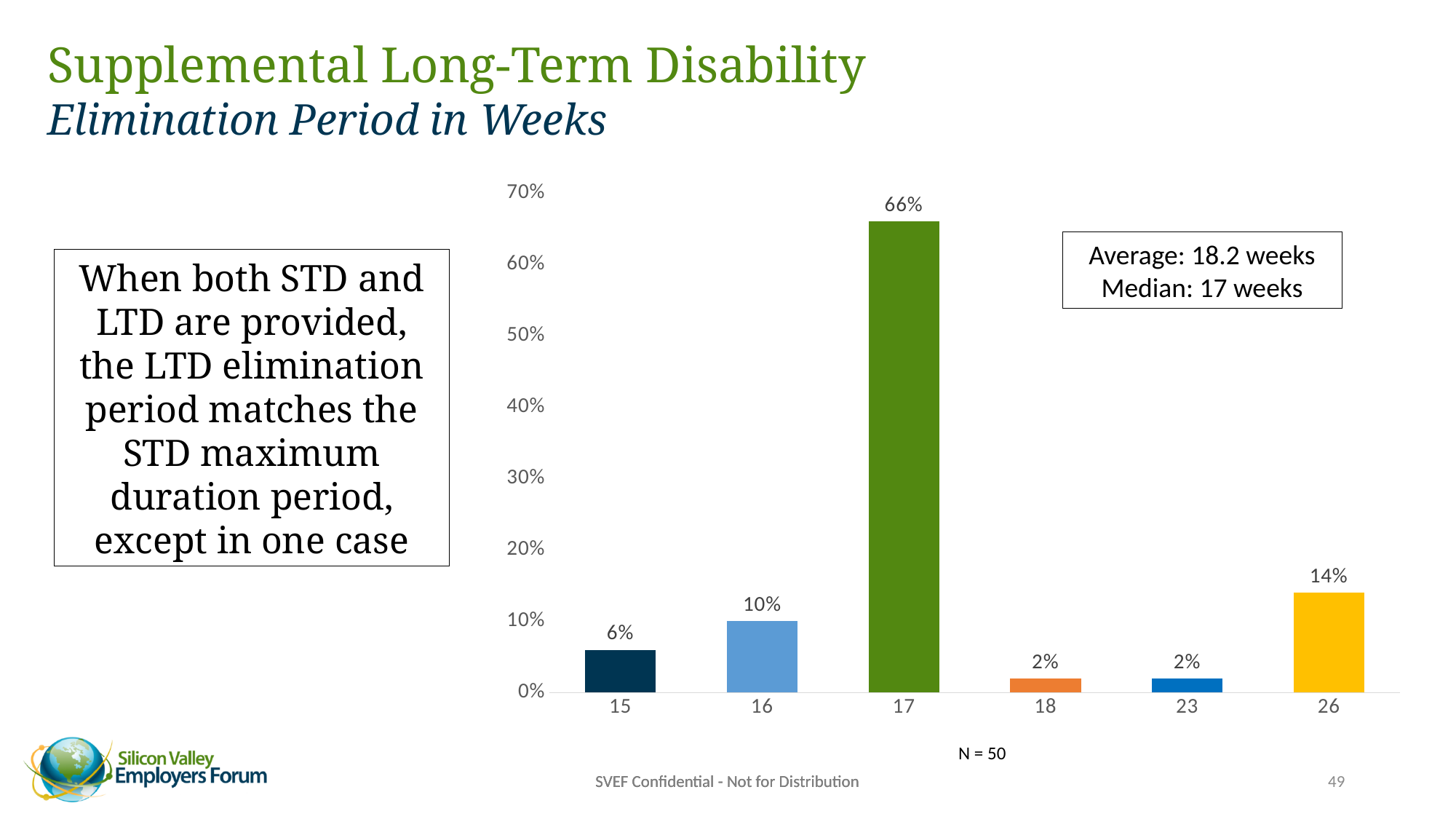
What is the sample size (N) noted below the chart? N = 50 How many elimination period categories are shown on the x axis? 6 Is the value for 17 weeks greater or less than 60%? greater What is the difference between the values for 16 weeks and 15 weeks? 4% What kind of chart is shown on the slide? Bar chart What is the average elimination period stated on the slide? 18.2 weeks What is the value shown for the 26-week elimination period? 14% What percentage of respondents have an elimination period of 17 weeks? 66% Which elimination period has the highest percentage? 17 Which is larger, the value for 16 weeks or the value for 26 weeks? 26 weeks What is the difference between the values for 17 weeks and 26 weeks? 52% What is the value shown for the 15-week elimination period? 6%